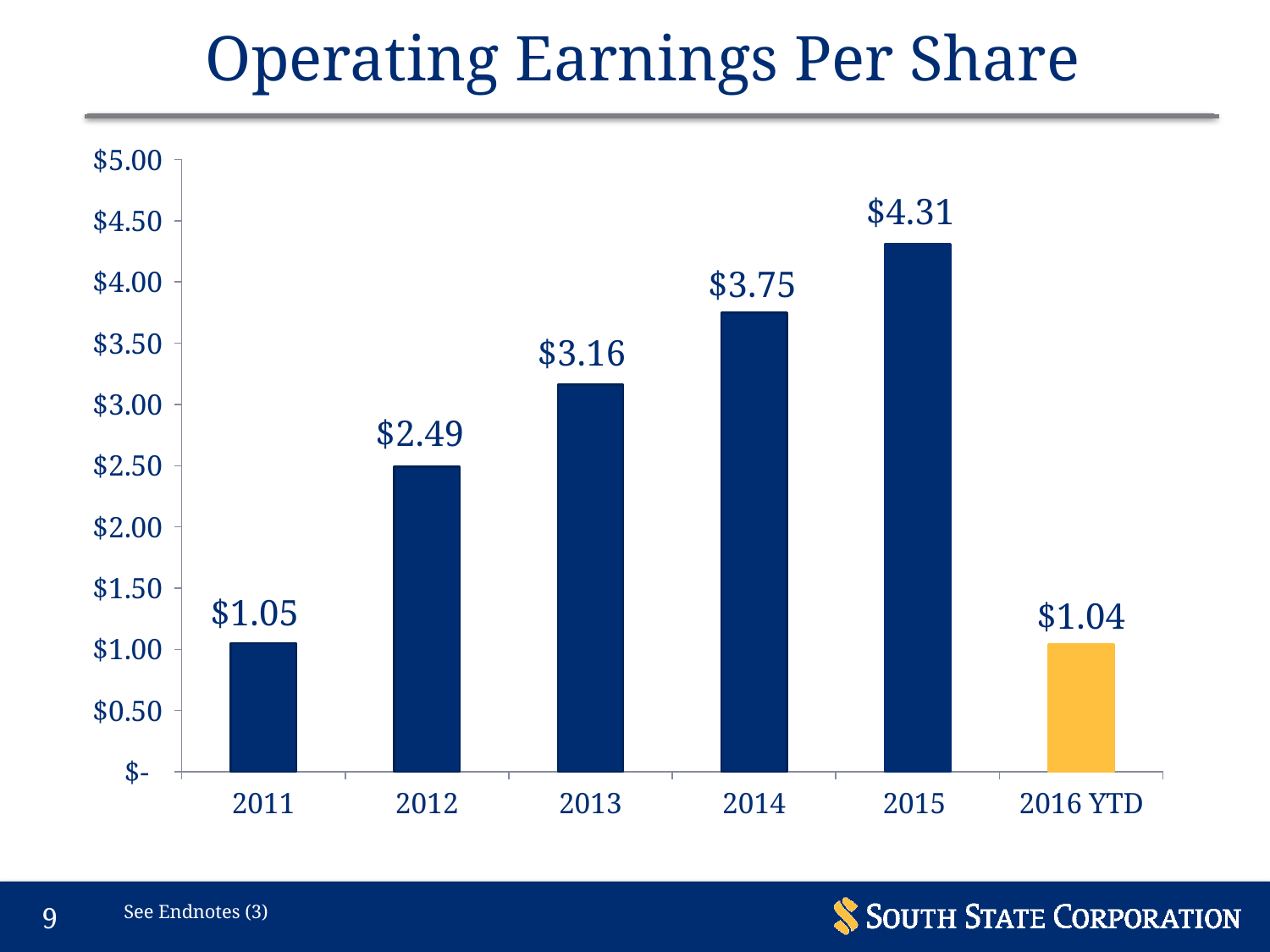
Do the values rise or fall from 2011 to 2015? Rise Which year has the highest operating earnings per share? 2015 Which is larger, the value for 2011 or the value for 2016 YTD? 2011 What is the operating earnings per share value for 2013? $3.16 Which bar is shown in a different colour (yellow) from the others? 2016 YTD Is the value for 2014 greater or less than $3.50? greater What is the operating earnings per share value for 2016 YTD? $1.04 What kind of chart is shown on the slide? Bar chart Which category has the lowest operating earnings per share? 2016 YTD What is the difference between the 2012 and 2011 operating earnings per share values? $1.44 How many categories are shown on the x axis? 6 What is the difference between the 2015 and 2014 operating earnings per share values? $0.56